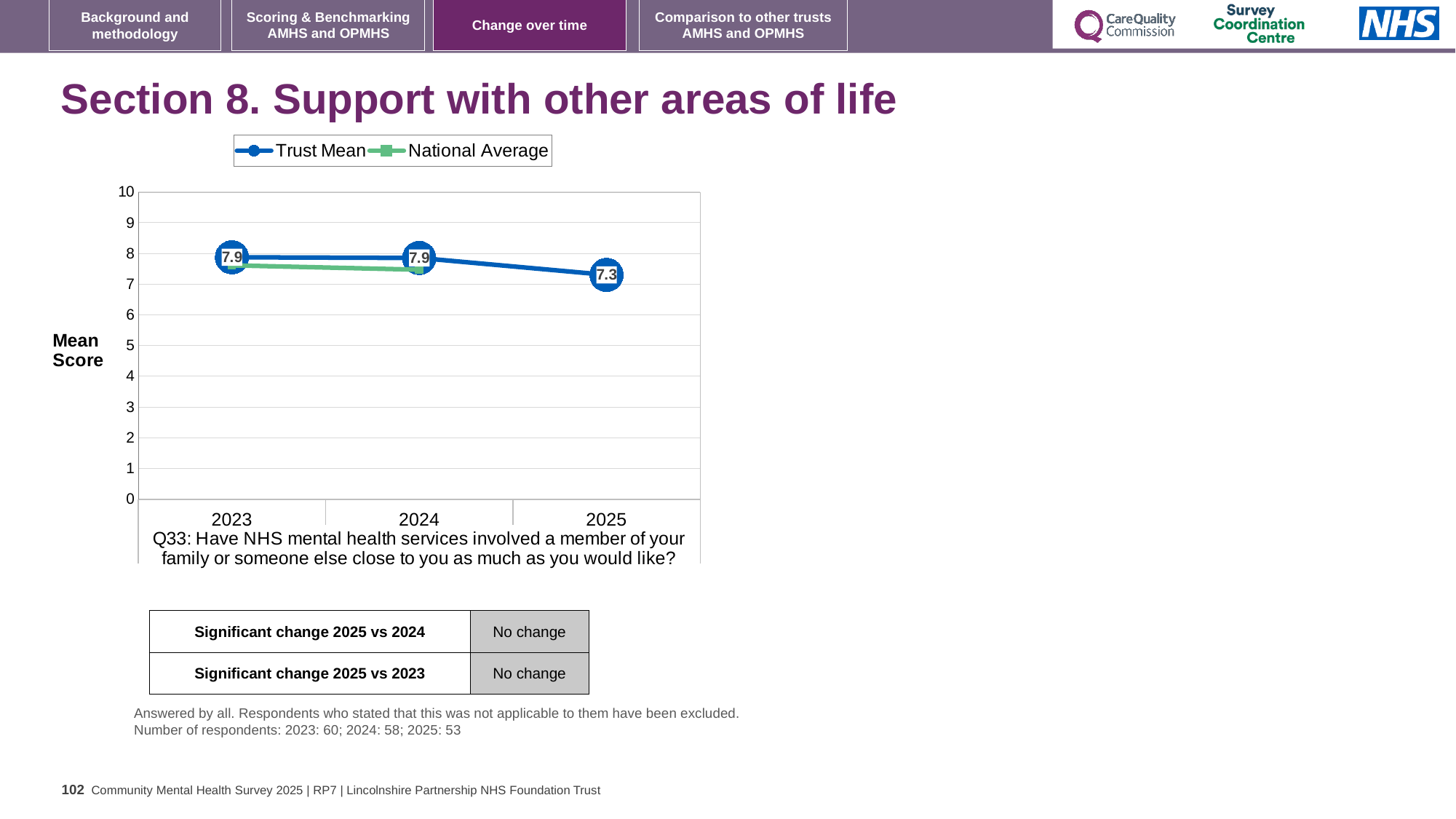
Is the National Average value for 2023 greater or less than 7? greater What is the Trust Mean value for 2023? 7.9 What is the difference between the Trust Mean in 2024 and in 2025? 0.6 What is the Trust Mean value for 2025? 7.3 How many years are plotted on the x axis? 3 Is the National Average value for 2024 greater or less than 8? less Which is larger, the Trust Mean for 2024 or for 2025? 2024 What kind of chart is shown? Line chart Does the Trust Mean rise or fall from 2024 to 2025? Fall How many series does the legend list? 2 What is the Trust Mean value for 2024? 7.9 Which year has the lowest Trust Mean? 2025